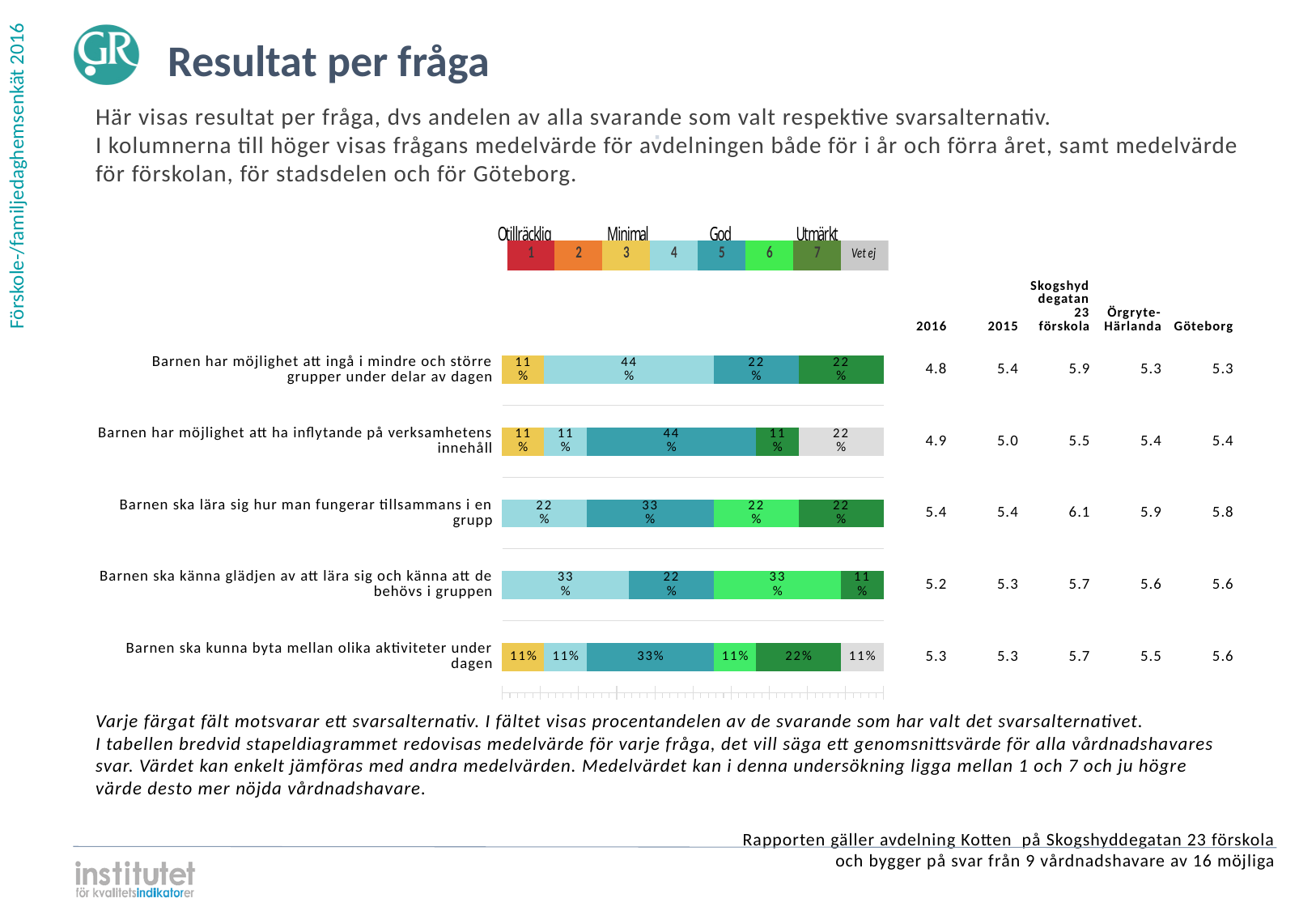
What kind of chart is used to show the share of respondents choosing each answer alternative? Stacked bar chart Which question has the highest mean value for Skogshyddegatan 23 förskola? Barnen ska lära sig hur man fungerar tillsammans i en grupp What percentage chose answer alternative 7 (dark green) for 'Barnen ska kunna byta mellan olika aktiviteter under dagen'? 22% What percentage of respondents answered 'Vet ej' for 'Barnen har möjlighet att ha inflytande på verksamhetens innehåll'? 22% What percentage of respondents chose answer alternative 4 (light blue) for 'Barnen har möjlighet att ingå i mindre och större grupper under delar av dagen'? 44% What is the difference between the 2015 and 2016 mean values for 'Barnen har möjlighet att ingå i mindre och större grupper under delar av dagen'? 0.6 For 'Barnen ska känna glädjen av att lära sig och känna att de behövs i gruppen', which is larger: the share choosing alternative 4 or the share choosing alternative 5? Alternative 4 (33%) How many questions (bars) are shown in the chart? 5 What percentage chose answer alternative 6 (bright green) for 'Barnen ska känna glädjen av att lära sig och känna att de behövs i gruppen'? 33% What is the 2016 mean value for 'Barnen ska lära sig hur man fungerar tillsammans i en grupp'? 5.4 Which question has the lowest 2016 mean value? Barnen har möjlighet att ingå i mindre och större grupper under delar av dagen How many answer alternatives does the legend above the chart list? 8